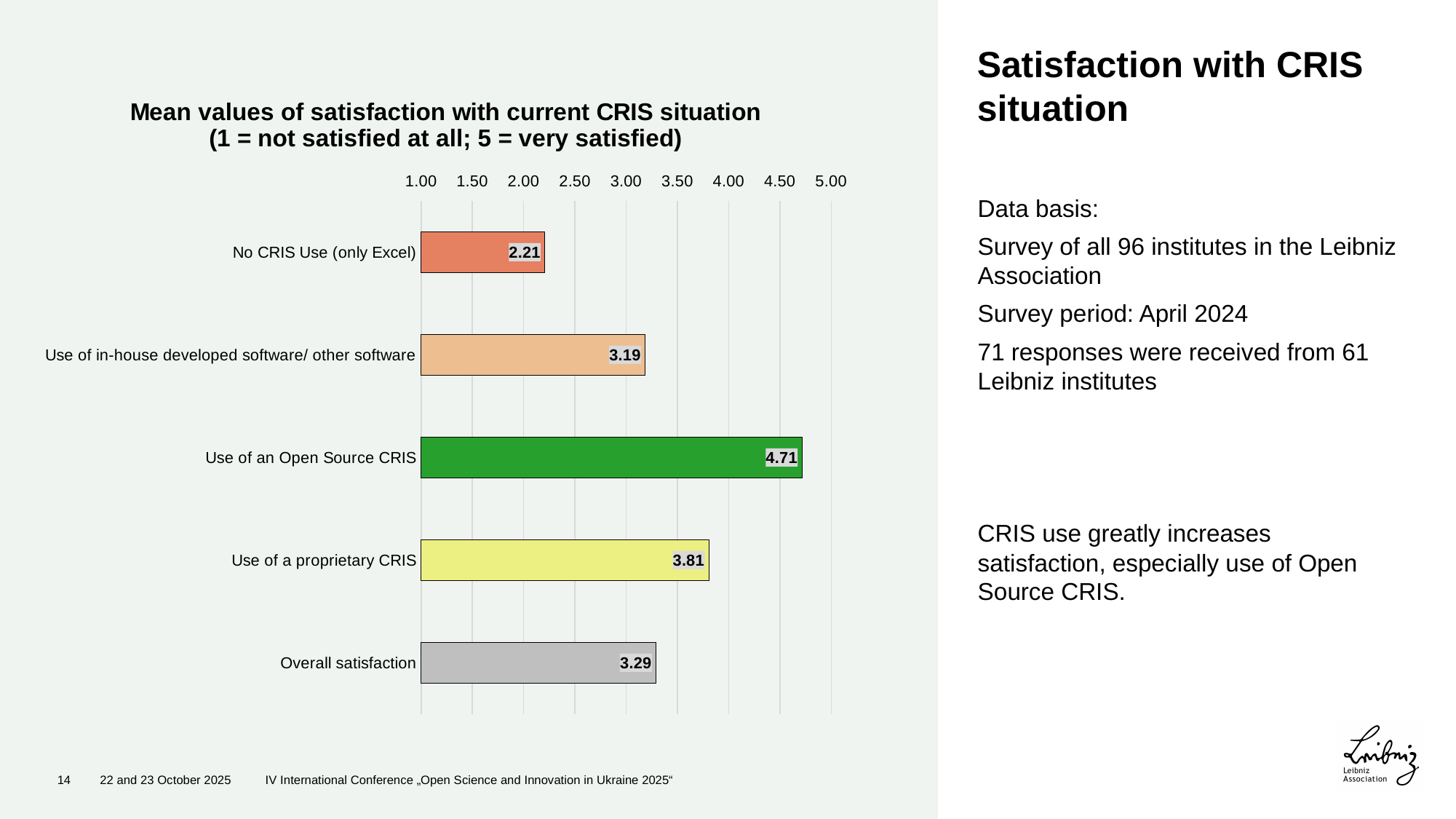
What is the value shown for 'Overall satisfaction'? 3.29 Which category has the highest mean satisfaction value? Use of an Open Source CRIS What kind of chart is shown on the slide? Bar chart What is the difference between the values for 'Use of an Open Source CRIS' and 'Use of a proprietary CRIS'? 0.90 Which has a higher mean satisfaction value: 'Use of in-house developed software/ other software' or 'Use of a proprietary CRIS'? Use of a proprietary CRIS Is the value for 'Use of in-house developed software/ other software' greater or less than 3.00? greater Which category has the lowest mean satisfaction value? No CRIS Use (only Excel) What is the title of the chart? Mean values of satisfaction with current CRIS situation (1 = not satisfied at all; 5 = very satisfied) What is the mean satisfaction value for 'Use of a proprietary CRIS'? 3.81 What is the mean satisfaction value for 'No CRIS Use (only Excel)'? 2.21 What is the mean satisfaction value for 'Use of an Open Source CRIS'? 4.71 How many categories are shown in the chart? 5